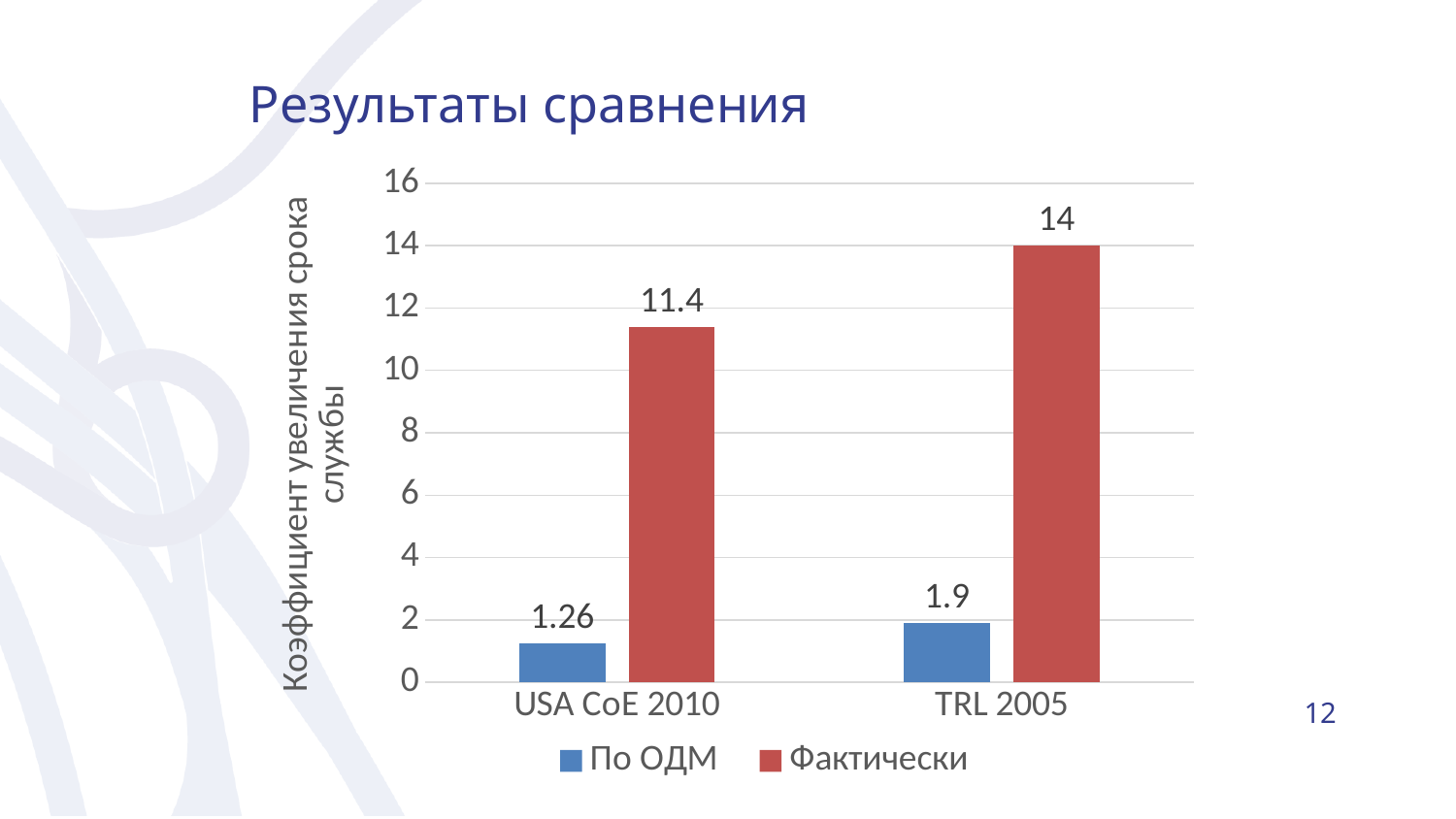
How many series does the legend list? 2 What is the label of the y axis? Коэффициент увеличения срока службы What is the difference between the Фактически and По ОДМ values for TRL 2005? 12.1 Which is larger: the Фактически value for USA CoE 2010 or for TRL 2005? TRL 2005 What is the value of Фактически for USA CoE 2010? 11.4 Which category has the lowest По ОДМ value? USA CoE 2010 What is the value of По ОДМ for USA CoE 2010? 1.26 What is the value of По ОДМ for TRL 2005? 1.9 Which category has the highest Фактически value? TRL 2005 How many categories are shown on the x axis? 2 What kind of chart is shown on the slide? Bar chart What is the value of Фактически for TRL 2005? 14